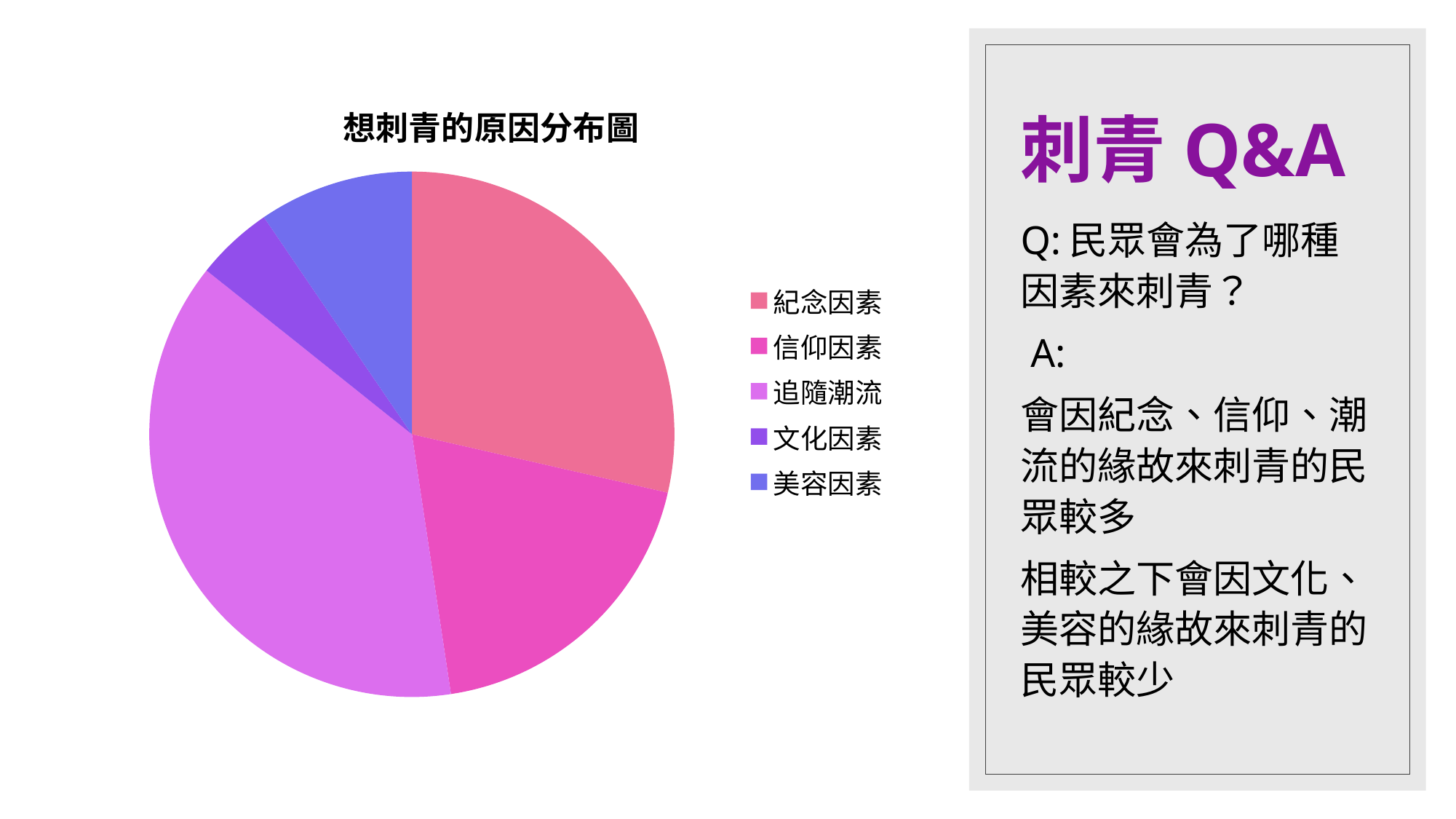
Which slice is larger, 信仰因素 or 美容因素? 信仰因素 Which category has the smallest slice in the pie chart? 文化因素 Which legend entry is shown in the blue colour in the pie chart? 美容因素 Which slice is larger, 紀念因素 or 信仰因素? 紀念因素 Which slice is larger, 追隨潮流 or 紀念因素? 追隨潮流 How many categories (slices) does the pie chart have? 5 What is the title of the pie chart? 想刺青的原因分布圖 How many entries does the legend of the pie chart list? 5 What kind of chart is shown on the slide? pie chart Which category has the largest slice in the pie chart? 追隨潮流